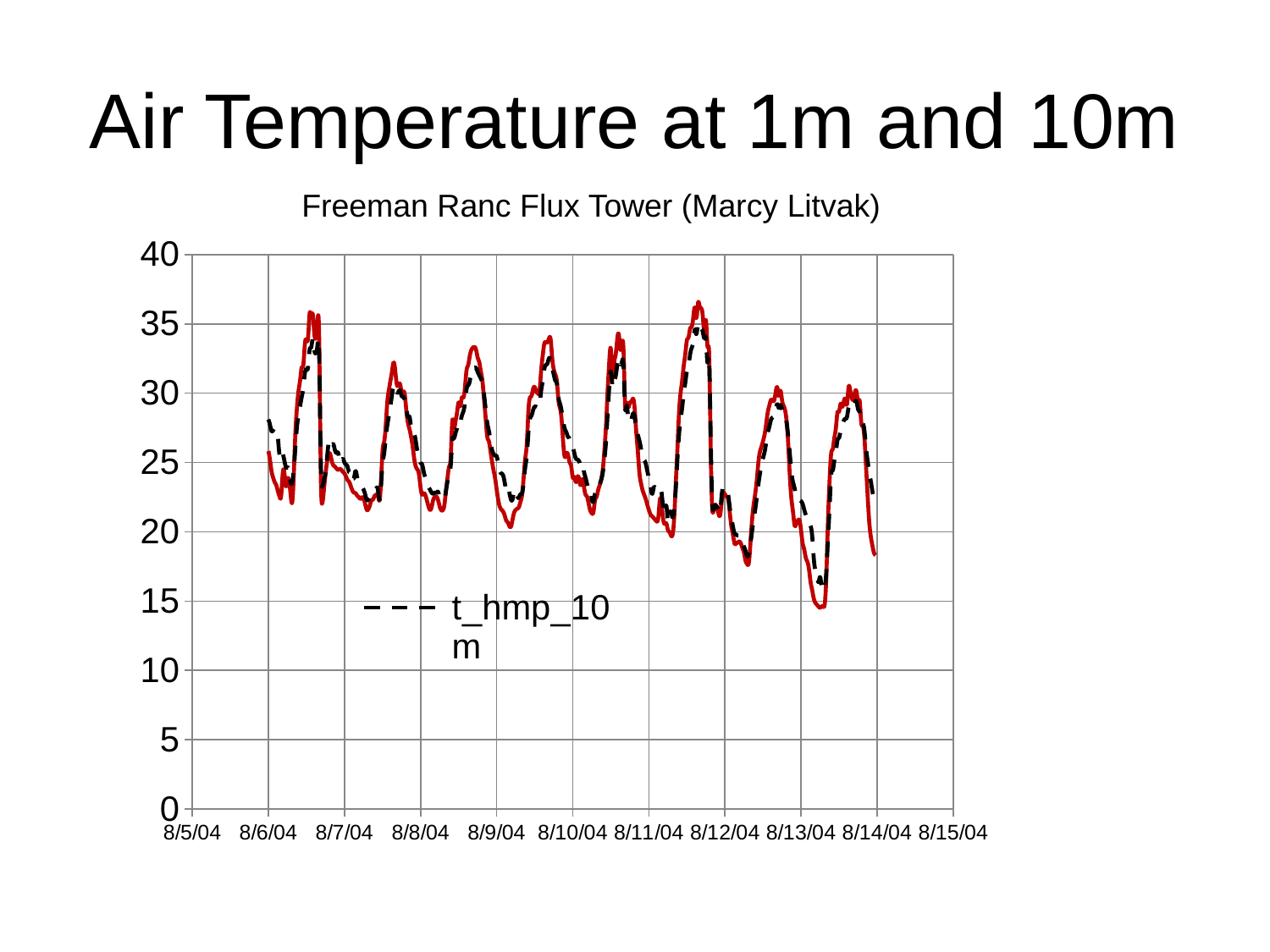
How many series does the chart's legend list? 1 What is the title printed above the chart? Freeman Ranc Flux Tower (Marcy Litvak) How many date labels are shown along the x axis? 11 Is the lowest value reached by the red solid line greater or less than 20? less Is the highest value reached by the red solid line greater or less than 35? greater What kind of chart is shown on the slide? line chart What is the name of the series shown in the legend? t_hmp_10 m Is the first value of the dashed t_hmp_10 m line at 8/6/04 greater or less than 25? greater Near the peak between 8/11/04 and 8/12/04, which line reaches the higher value, the red solid line or the black dashed line? the red solid line